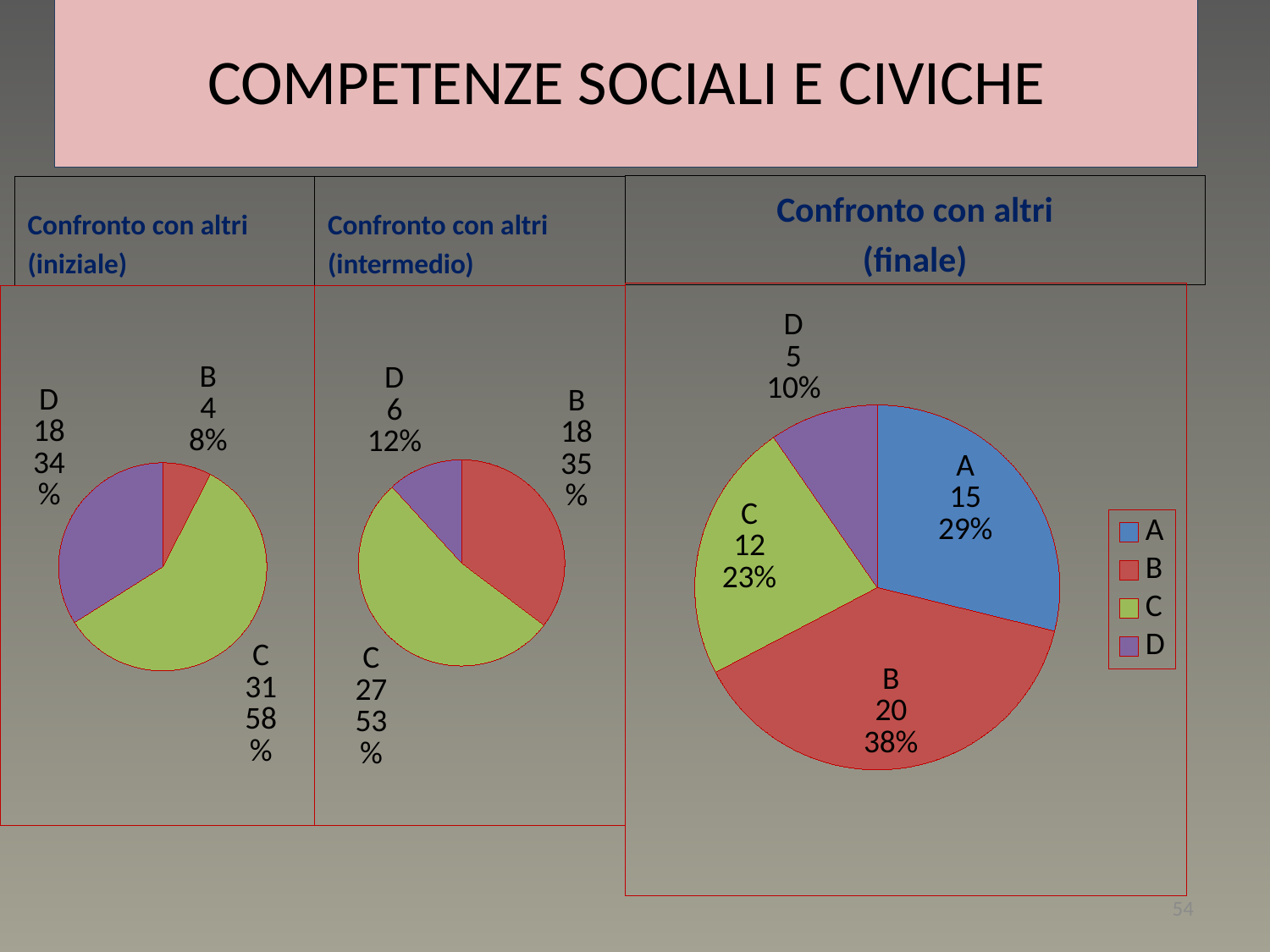
In the 'Confronto con altri (iniziale)' chart, which category has the smallest slice? B In the 'Confronto con altri (finale)' chart, what is the value for category B? 20 In the 'Confronto con altri (iniziale)' chart, which is larger, the value for D or the value for B? D In the 'Confronto con altri (finale)' chart, what is the difference between the values for B and D? 15 How many slices does the 'Confronto con altri (finale)' chart have? 4 In the 'Confronto con altri (finale)' chart, what percentage share does category A have? 29% In the 'Confronto con altri (finale)' chart, which category has the largest slice? B In the 'Confronto con altri (intermedio)' chart, which category has the largest slice? C In the 'Confronto con altri (intermedio)' chart, what percentage share does category D have? 12% How many entries does the legend of the 'Confronto con altri (finale)' chart list? 4 What kind of chart is used for 'Confronto con altri (intermedio)'? Pie chart In the 'Confronto con altri (iniziale)' chart, what is the value for category C? 31